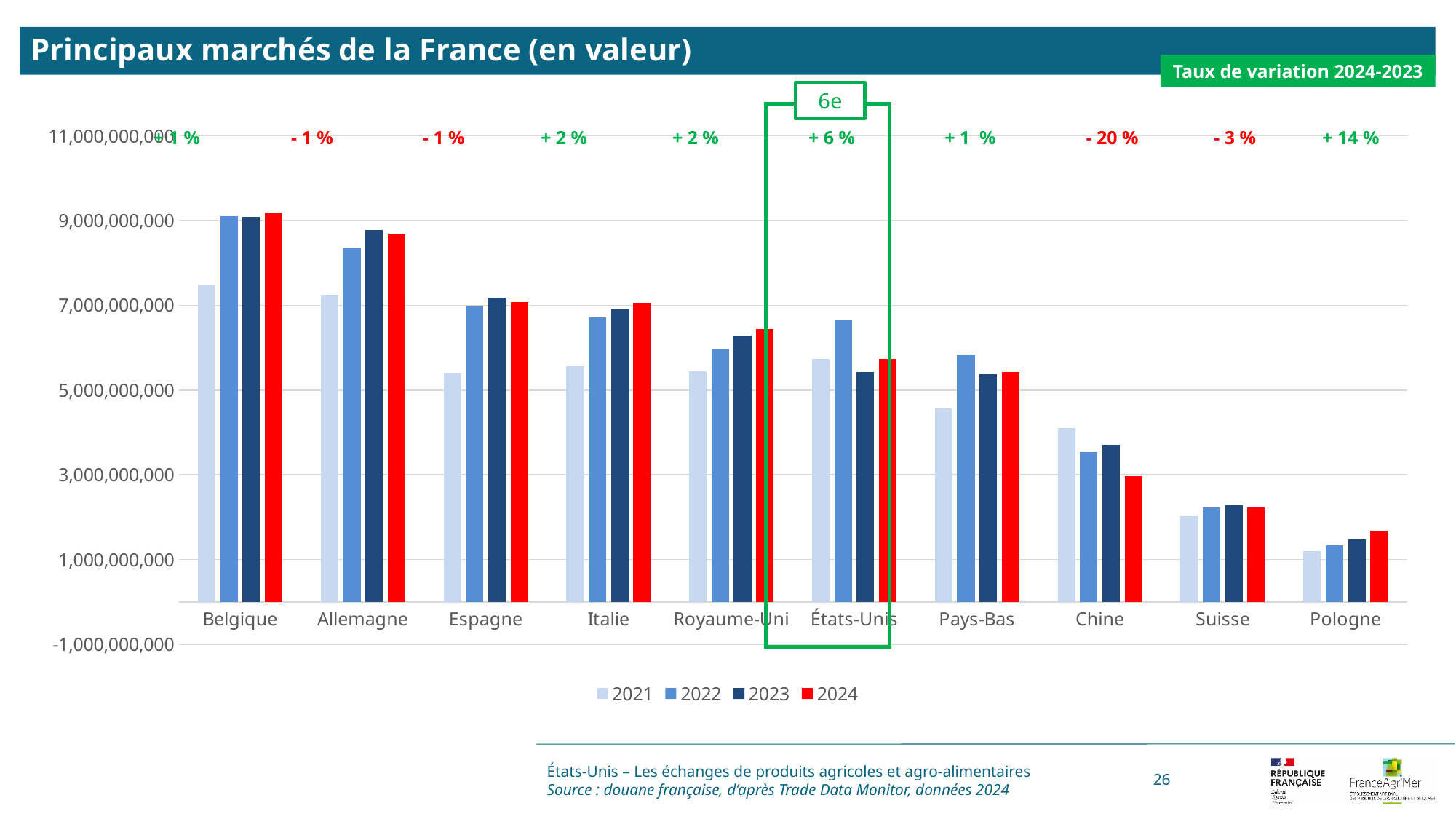
What kind of chart is shown on the slide? bar chart What is the 2024-2023 variation rate shown above Chine? - 20 % Which country has the highest value for 2024? Belgique How many countries are shown on the x axis of the chart? 10 Is the 2024 value for Belgique greater or less than 9,000,000,000? greater Which country has the lowest value for 2024? Pologne What is the 2024-2023 variation rate shown above Pologne? + 14 % Is the 2021 value for Chine greater or less than 3,000,000,000? greater Is the 2024 value for Allemagne greater or less than 9,000,000,000? less Do the 2024 values generally rise or fall from Belgique to Pologne along the x axis? fall Which is larger: the 2024 value for Chine or the 2024 value for Suisse? Chine How many series does the legend list? 4